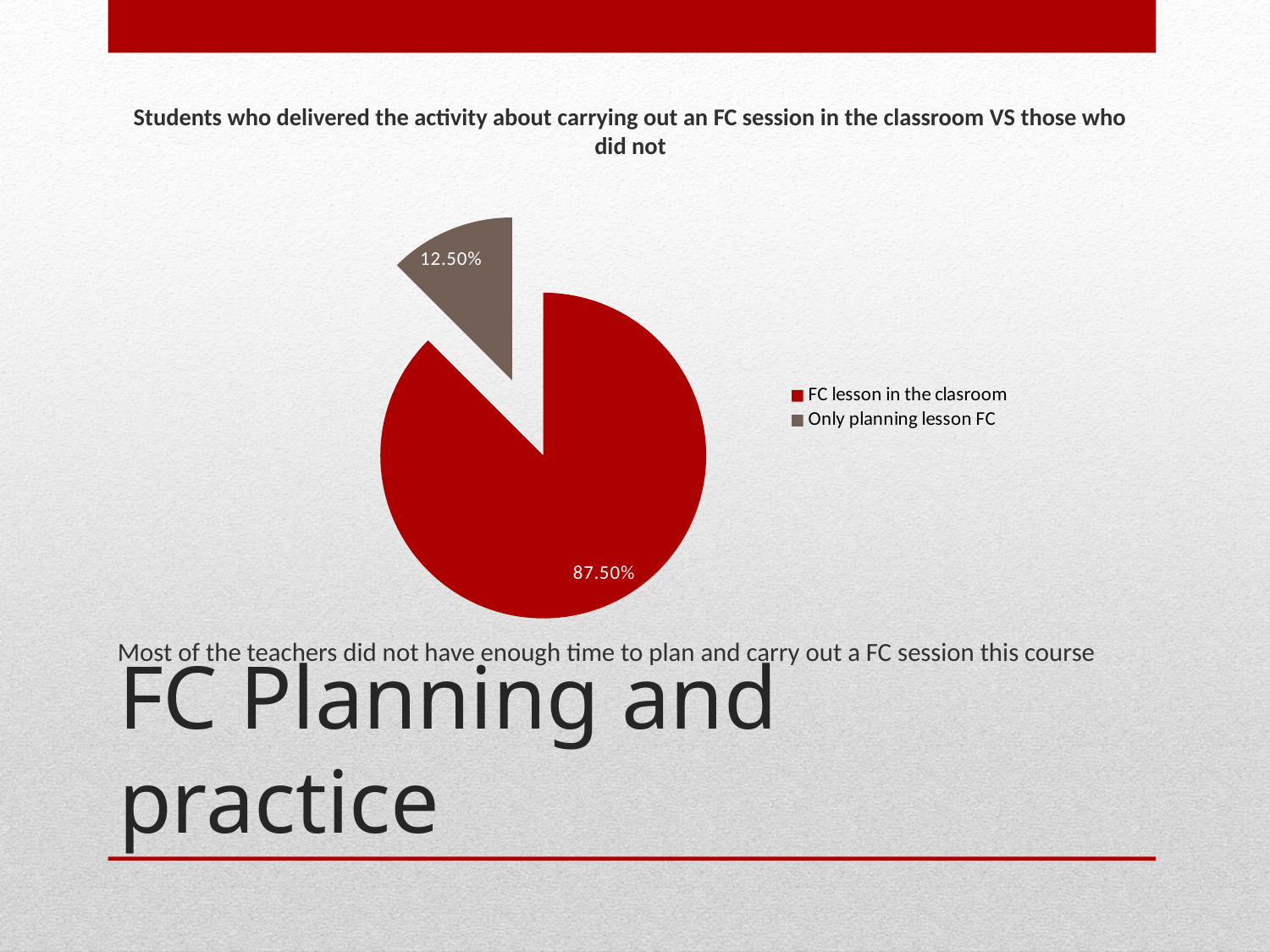
What share of the pie is labelled "FC lesson in the clasroom"? 87.50% Which is larger: the share for "FC lesson in the clasroom" or the share for "Only planning lesson FC"? FC lesson in the clasroom What is the difference between the "FC lesson in the clasroom" share and the "Only planning lesson FC" share? 75.00% What is the title of the chart? Students who delivered the activity about carrying out an FC session in the classroom VS those who did not Which slice of the pie is the largest? FC lesson in the clasroom Which slice of the pie is the smallest? Only planning lesson FC What colour is the "Only planning lesson FC" slice? grey-brown How many slices does the pie chart have? 2 How many entries does the legend list? 2 What kind of chart is shown on the slide? pie chart What share of the pie is labelled "Only planning lesson FC"? 12.50% Is the share for "FC lesson in the clasroom" greater or less than 50%? greater